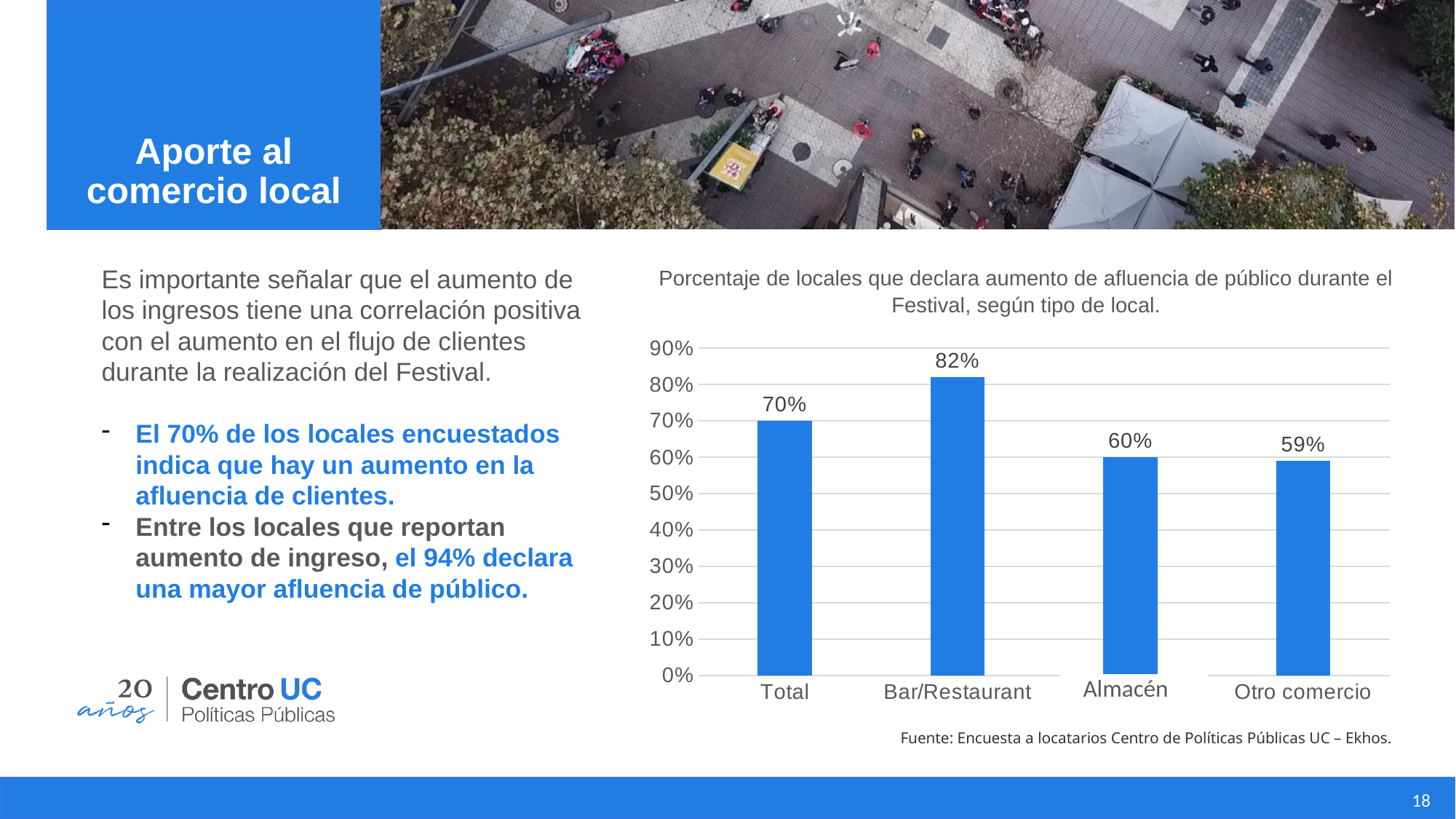
What is the difference between the values for Bar/Restaurant and Total? 12% What is the difference between the values for Total and Almacén? 10% Is the value for Otro comercio greater or less than 70%? less Which category has the highest value? Bar/Restaurant How many categories are shown on the x axis? 4 What is the value for Bar/Restaurant? 82% What is the title of the chart? Porcentaje de locales que declara aumento de afluencia de público durante el Festival, según tipo de local. What kind of chart is shown on the slide? bar chart What is the value for Total? 70% Which is larger, the value for Bar/Restaurant or the value for Almacén? Bar/Restaurant What is the value for Almacén? 60% What is the value for Otro comercio? 59%